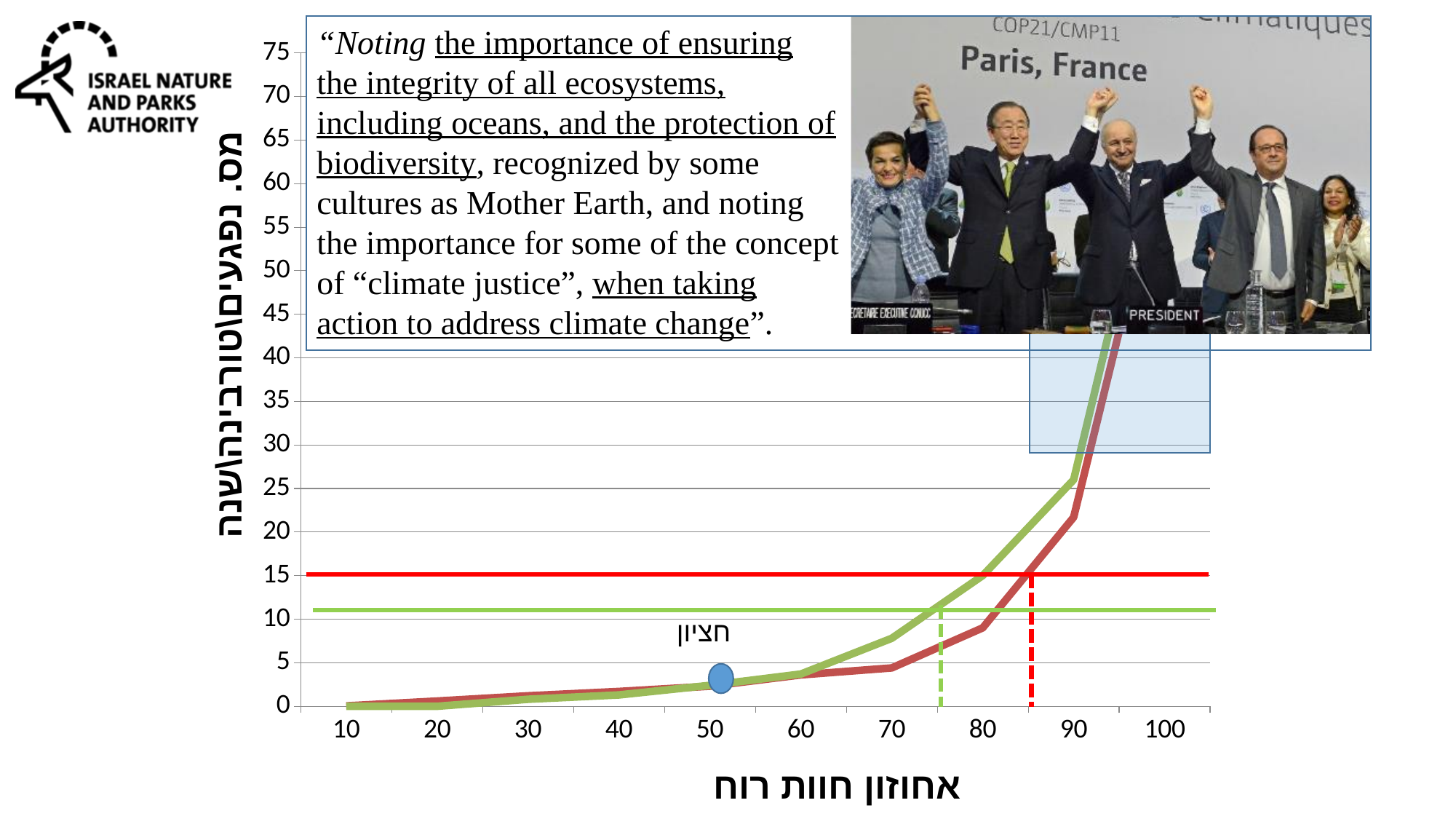
How many plotted lines (series) are drawn on the chart? 2 At x = 90, which line has the higher value, the green line or the red line? green line Is the value of the green line at x = 90 greater or less than 20? greater At which x-axis value do both lines reach their highest point? 100 At what y-axis value is the solid horizontal red line drawn? 15 What kind of chart is shown on the slide? line chart Is the value of the green line at x = 80 greater or less than 10? greater Do the values of the green line rise or fall as the x axis increases from 10 to 100? rise Do the values of the red line rise or fall as the x axis increases from 10 to 100? rise Is the value of the red line at x = 90 greater or less than 20? greater What is the label on the x axis of the chart? אחוזון חוות רוח